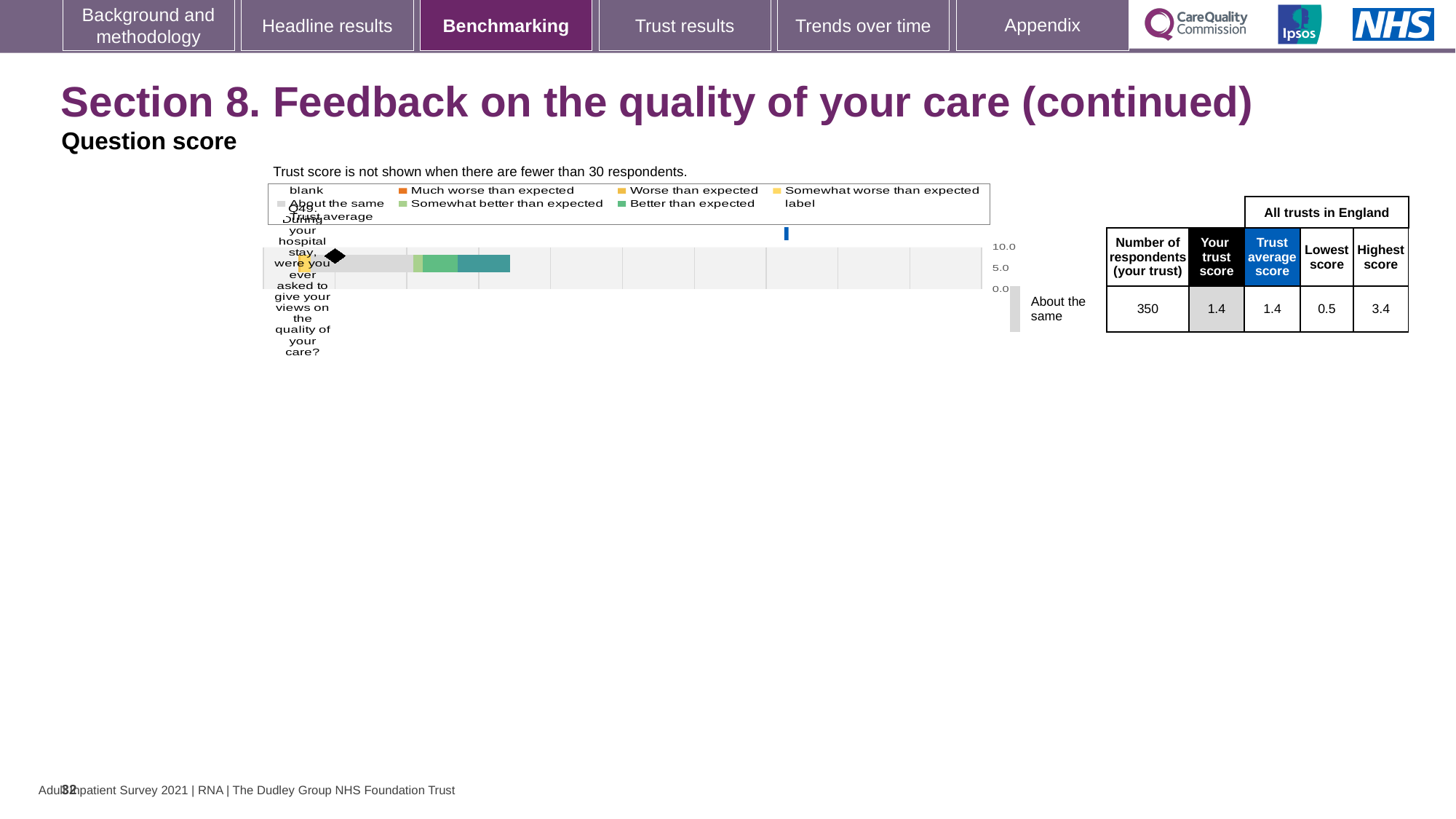
What is the trust average score for Q49 shown next to the chart? 1.4 Which benchmarking category is the trust's Q49 result placed in? About the same What is the trust score for Q49 shown next to the chart? 1.4 How many respondents from the trust answered Q49? 350 Is the trust score for Q49 greater or less than 5.0? less What is the highest score across all trusts in England for Q49? 3.4 How many questions are plotted in the benchmarking chart on this slide? 1 What is the lowest score across all trusts in England for Q49? 0.5 What type of chart is used to show the benchmarking result for Q49? bar chart Which question is plotted in the benchmarking chart? Q49. During your hospital stay, were you ever asked to give your views on the quality of your care? What is the difference between the highest score and the lowest score across all trusts in England for Q49? 2.9 Which is larger for Q49: the trust's score or the highest score across all trusts in England? Highest score